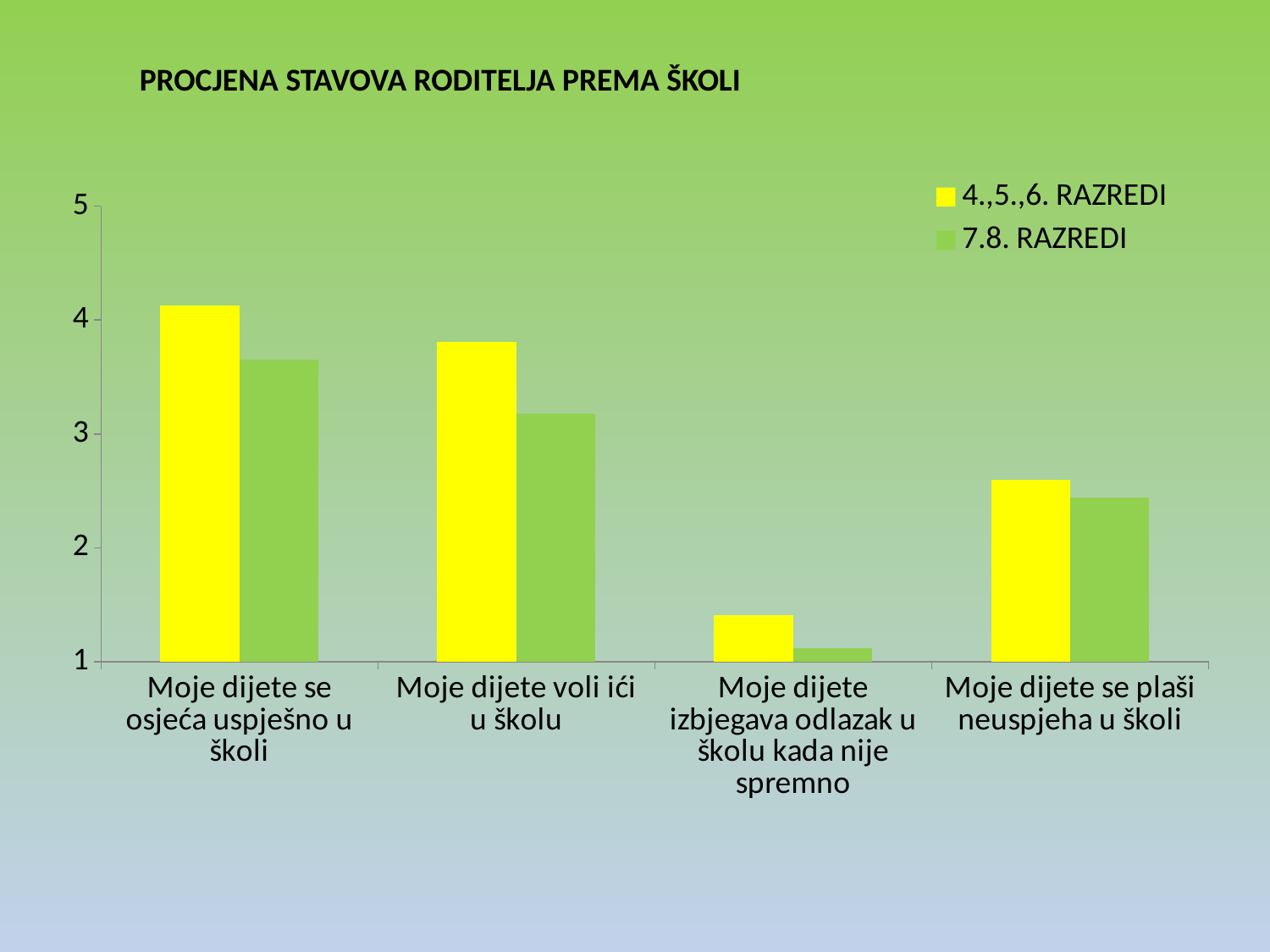
Is the value for 4.,5.,6. RAZREDI in 'Moje dijete izbjegava odlazak u školu kada nije spremno' greater or less than 2? less Is the value for 4.,5.,6. RAZREDI in 'Moje dijete voli ići u školu' greater or less than 3? greater Which category has the lowest value for the 7.8. RAZREDI series? Moje dijete izbjegava odlazak u školu kada nije spremno Is the value for 7.8. RAZREDI in 'Moje dijete se osjeća uspješno u školi' greater or less than 4? less For 'Moje dijete se osjeća uspješno u školi', which series has the larger value, 4.,5.,6. RAZREDI or 7.8. RAZREDI? 4.,5.,6. RAZREDI What is the title of the chart? PROCJENA STAVOVA RODITELJA PREMA ŠKOLI How many series does the legend list? 2 Which category has the highest value for the 4.,5.,6. RAZREDI series? Moje dijete se osjeća uspješno u školi For 'Moje dijete voli ići u školu', which series has the larger value, 4.,5.,6. RAZREDI or 7.8. RAZREDI? 4.,5.,6. RAZREDI How many categories are shown on the x axis? 4 What kind of chart is shown on the slide? bar chart